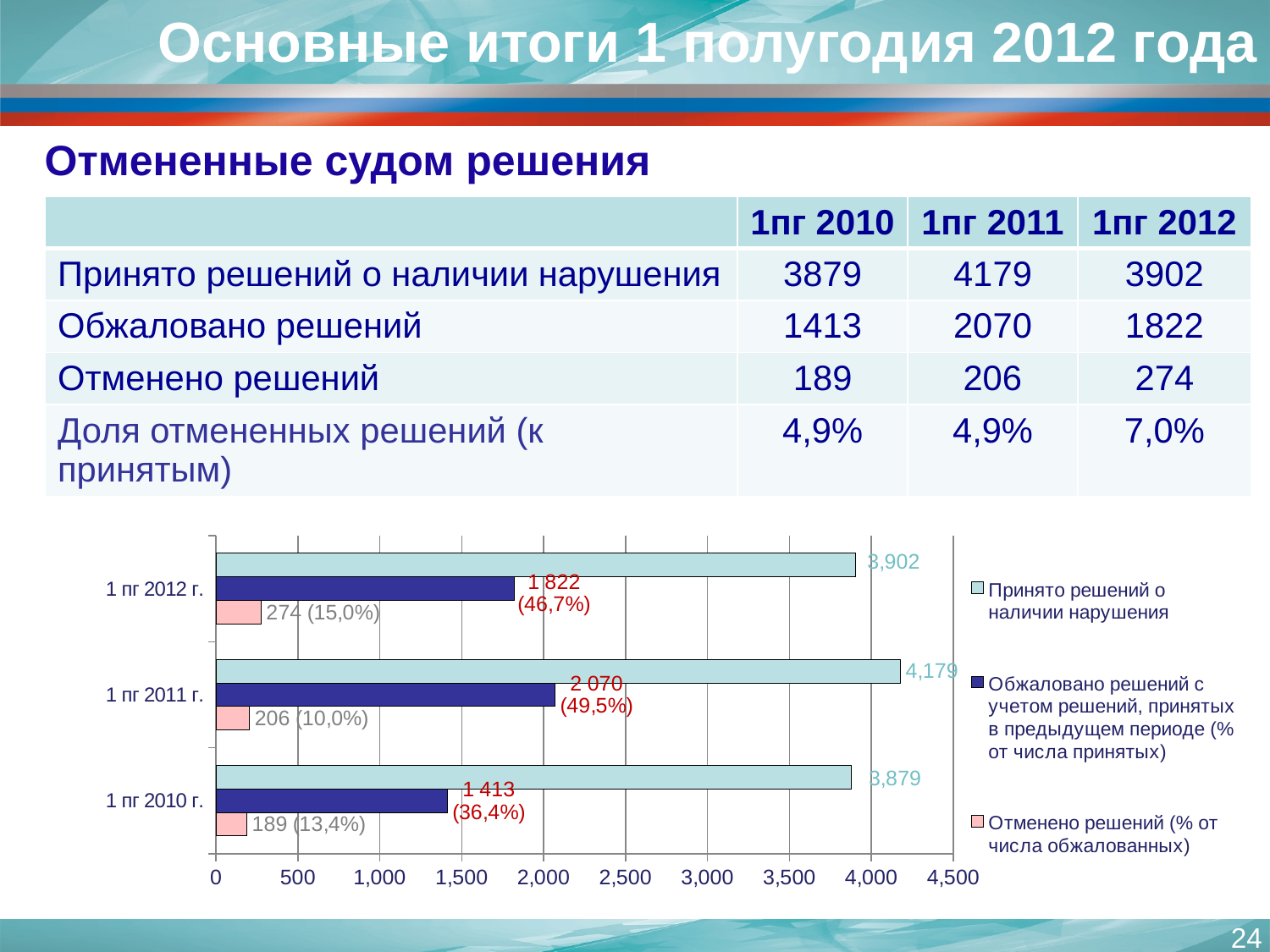
In the chart, is 'Обжаловано решений' larger for 1 пг 2012 г. or for 1 пг 2010 г.? 1 пг 2012 г. How many series does the chart legend list? 3 In the chart, which period has the lowest value for 'Отменено решений'? 1 пг 2010 г. What kind of chart is shown on the slide? bar chart How many categories (periods) are shown on the chart's vertical axis? 3 In the chart, what is the difference between 'Обжаловано решений' for 1 пг 2011 г. and 1 пг 2010 г.? 657 In the chart, what is the value of 'Обжаловано решений' for 1 пг 2012 г.? 1 822 In the chart, is the value of 'Принято решений о наличии нарушения' for 1 пг 2010 г. greater or less than 4,000? less In the chart, which period has the highest value for 'Принято решений о наличии нарушения'? 1 пг 2011 г. In the chart, what percentage is shown next to the 'Отменено решений' bar for 1 пг 2010 г.? 13,4% In the chart, what is the value of 'Принято решений о наличии нарушения' for 1 пг 2011 г.? 4,179 What is the maximum value shown on the chart's horizontal axis? 4,500